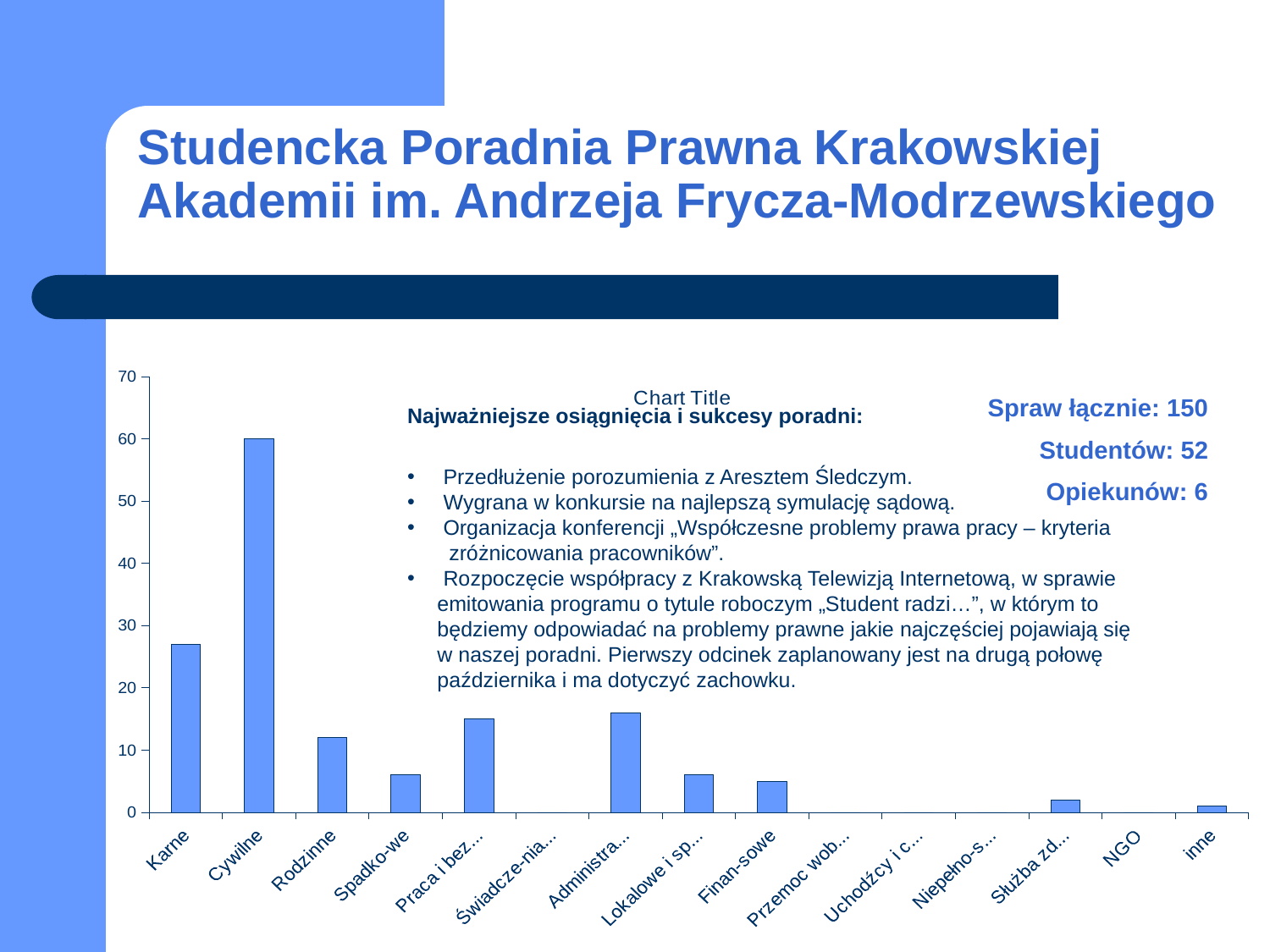
What type of chart is shown on the slide? bar chart Is the value for Finan-sowe greater or less than 10? less Which is larger, the value for Cywilne or the value for Karne? Cywilne What is the value for Cywilne? 60 Which is larger, the value for Karne or the value for Rodzinne? Karne Which category has the highest value in the chart? Cywilne How many categories are shown on the x axis of the chart? 15 Is the value for Spadko-we greater or less than 10? less What is the title shown on the chart? Chart Title Is the value for Karne greater or less than 30? less